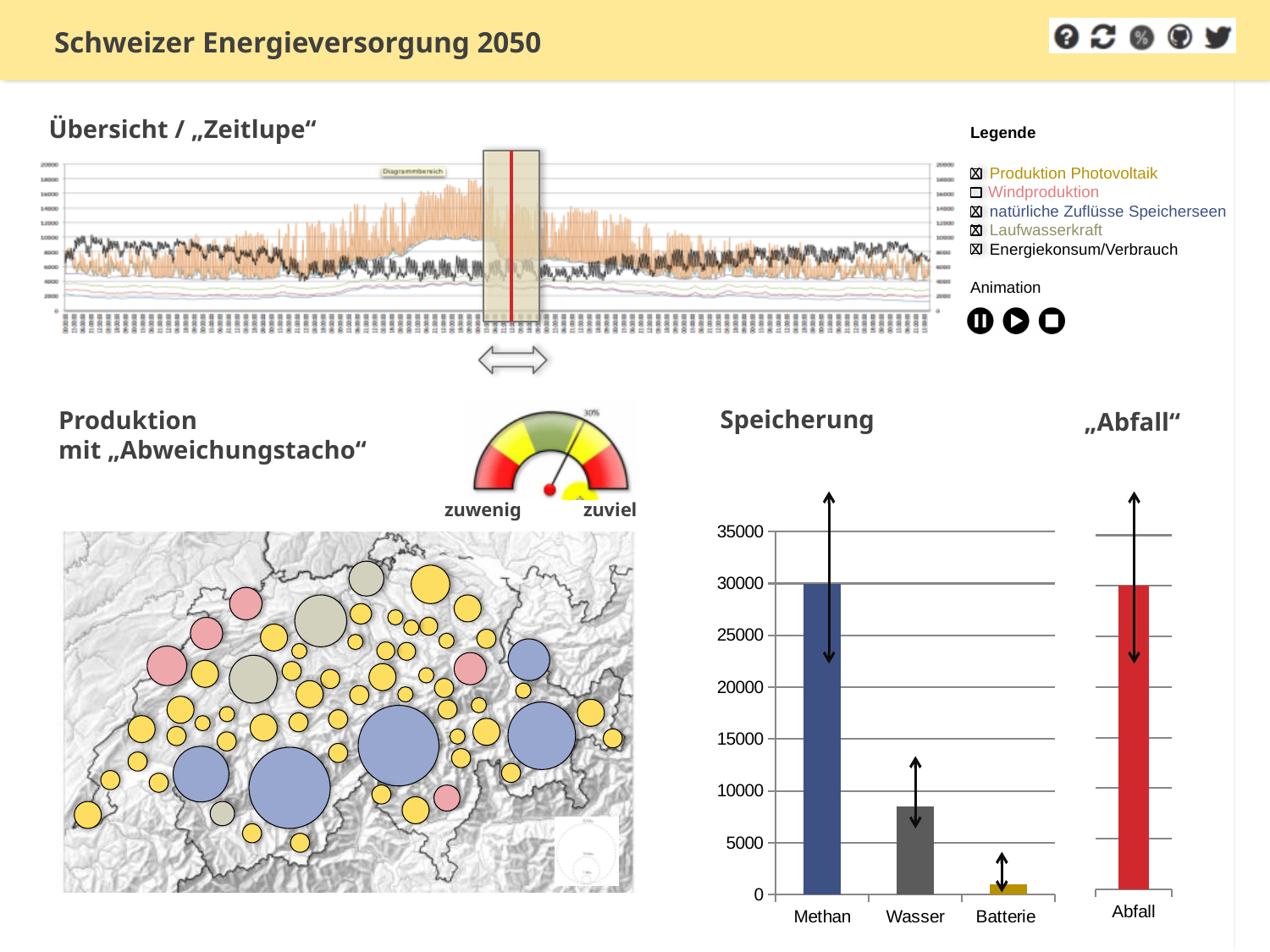
What kind of chart is the Speicherung chart? bar chart In the Speicherung chart, is the value for Wasser greater or less than 10000? less In the Speicherung chart, is the value for Batterie greater or less than 5000? less In the Speicherung chart, is the value for Wasser greater or less than 5000? greater In the Speicherung chart, which category has the lowest value? Batterie How many entries does the legend of the Übersicht / "Zeitlupe" chart list? 5 How many categories are shown in the Speicherung bar chart (excluding the separate Abfall bar)? 3 In the Speicherung chart, which is larger, Wasser or Batterie? Wasser What is the highest value shown on the y axis of the Speicherung chart? 35000 In the Speicherung chart, which category has the highest value? Methan